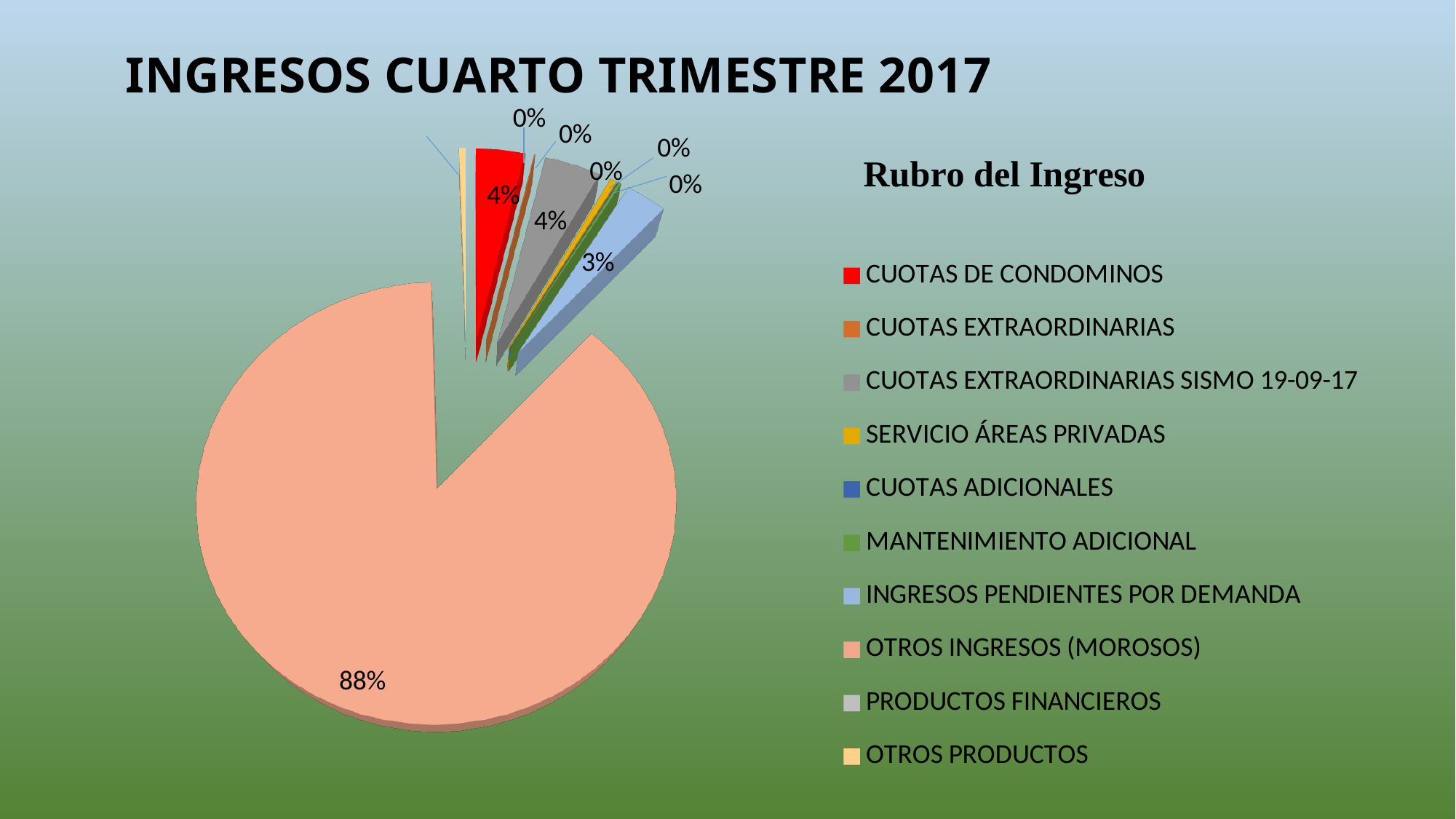
What percentage is shown for INGRESOS PENDIENTES POR DEMANDA? 3% What kind of chart is shown on the slide? Pie chart What is the title of the chart? INGRESOS CUARTO TRIMESTRE 2017 Which is larger, the share for CUOTAS DE CONDOMINOS or the share for INGRESOS PENDIENTES POR DEMANDA? CUOTAS DE CONDOMINOS What is the difference in percentage points between OTROS INGRESOS (MOROSOS) and CUOTAS DE CONDOMINOS? 84 percentage points What percentage is shown for MANTENIMIENTO ADICIONAL? 0% What percentage is shown for CUOTAS DE CONDOMINOS? 4% What percentage of the pie does OTROS INGRESOS (MOROSOS) represent? 88% Which category has the largest slice of the pie? OTROS INGRESOS (MOROSOS) What percentage is shown for CUOTAS EXTRAORDINARIAS SISMO 19-09-17? 4% How many categories does the legend list? 10 What is the heading shown above the legend? Rubro del Ingreso